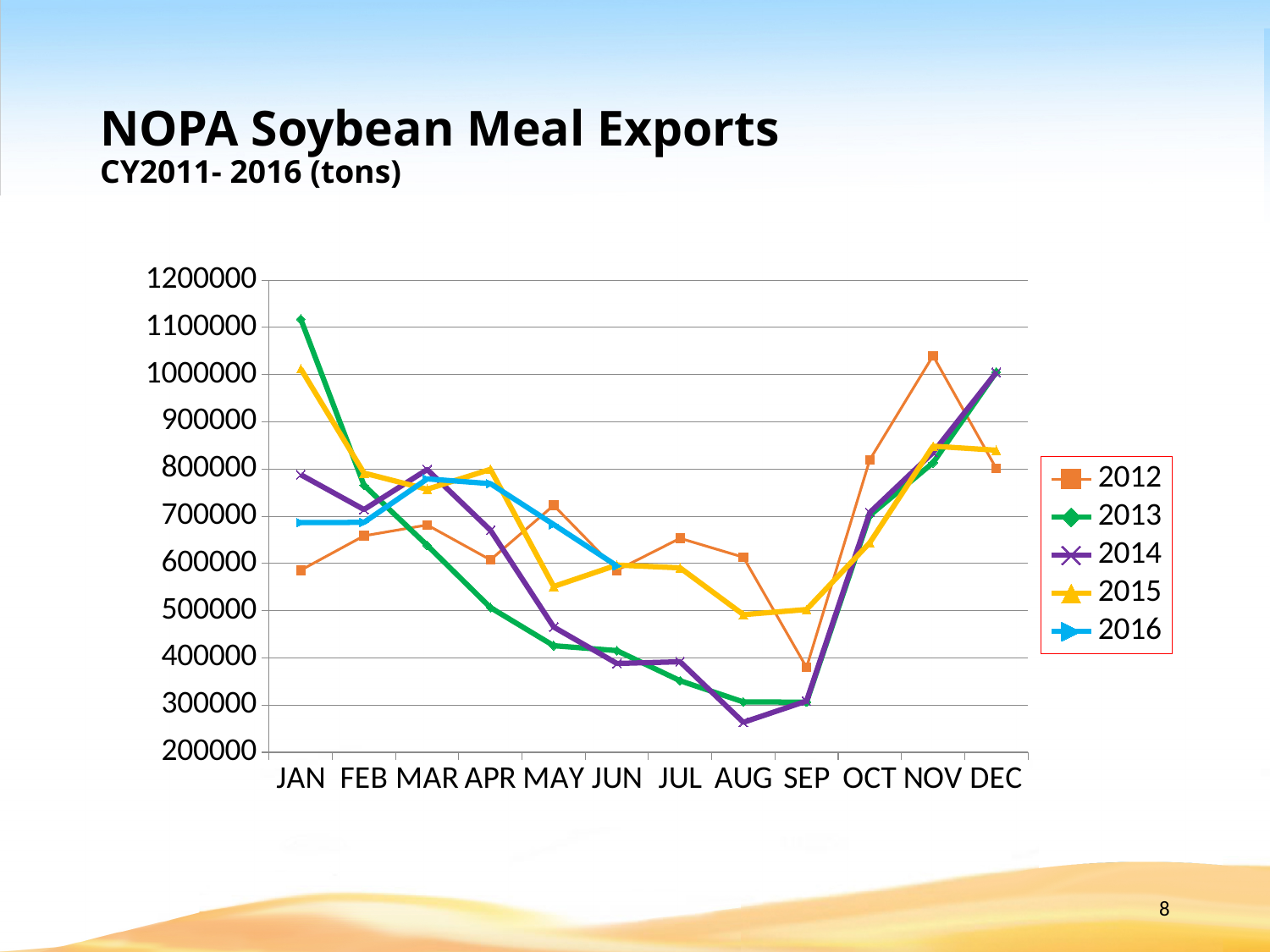
How many series does the legend list? 5 What kind of chart is shown on the slide? line chart Does the 2013 series rise or fall from JAN to AUG? fall Which is larger in NOV, the value for 2012 or the value for 2013? 2012 Is the value for 2012 in NOV greater or less than 1000000? greater Is the value for 2012 in SEP greater or less than 400000? less In which month does the 2012 series reach its highest value? NOV Is the value for 2014 in AUG greater or less than 300000? less How many months are shown along the x axis? 12 What is the title of the chart on the slide? NOPA Soybean Meal Exports Which year has the highest value in JAN? 2013 In which month does the 2014 series reach its lowest value? AUG